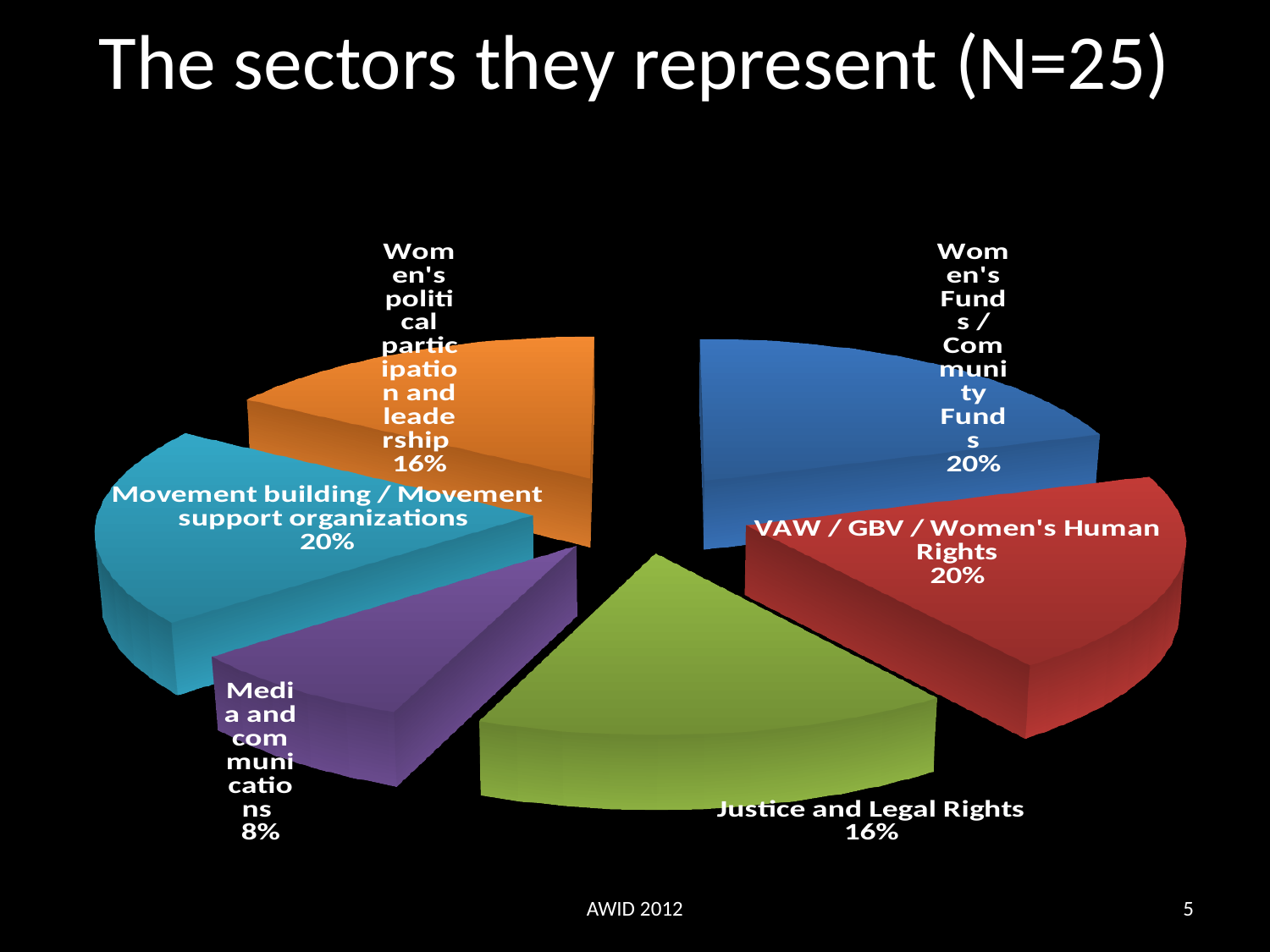
What share of the pie does Justice and Legal Rights represent? 16% What share of the pie does Women's Funds / Community Funds represent? 20% What share of the pie does Movement building / Movement support organizations represent? 20% What is the difference in percentage points between the share for VAW / GBV / Women's Human Rights and the share for Media and communications? 12 percentage points What is the title of the chart on the slide? The sectors they represent (N=25) Which has a larger share: Movement building / Movement support organizations or Media and communications? Movement building / Movement support organizations What kind of chart is shown on the slide? pie chart Which sector has the smallest share of the pie? Media and communications How many sectors (slices) are shown in the pie chart? 6